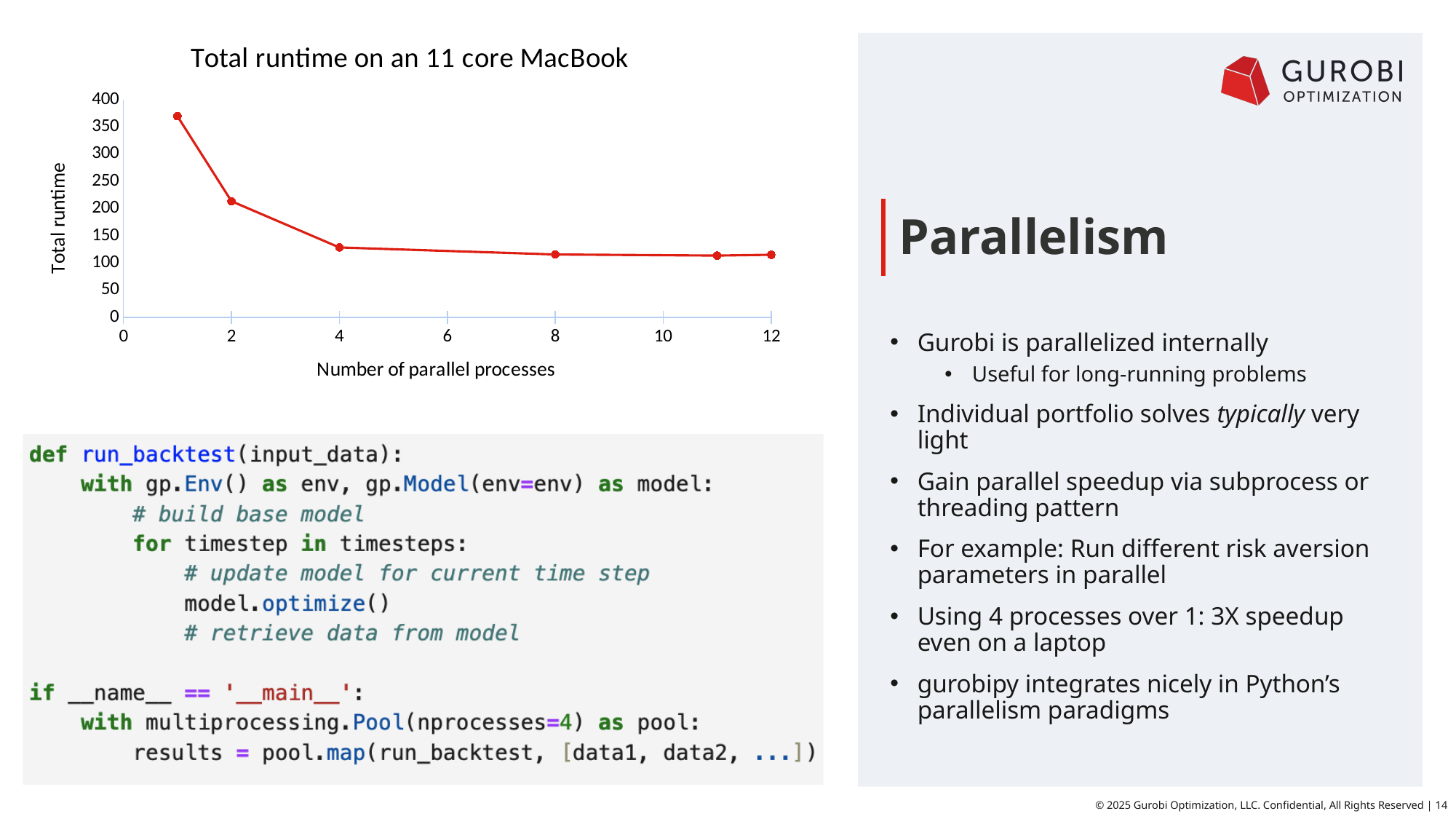
What is the title of the chart? Total runtime on an 11 core MacBook Which has the larger total runtime: 1 parallel process or 2 parallel processes? 1 parallel process Is the total runtime for 4 parallel processes greater or less than 100? greater Which has the larger total runtime: 2 parallel processes or 4 parallel processes? 2 parallel processes What is the label of the x axis of the chart? Number of parallel processes Is the total runtime for 2 parallel processes greater or less than 250? less What kind of chart is shown on the slide? line chart How many data points are plotted on the line? 6 At which number of parallel processes is the total runtime highest? 1 Does the total runtime rise or fall as the number of parallel processes increases? fall Is the total runtime for 1 parallel process greater or less than 350? greater